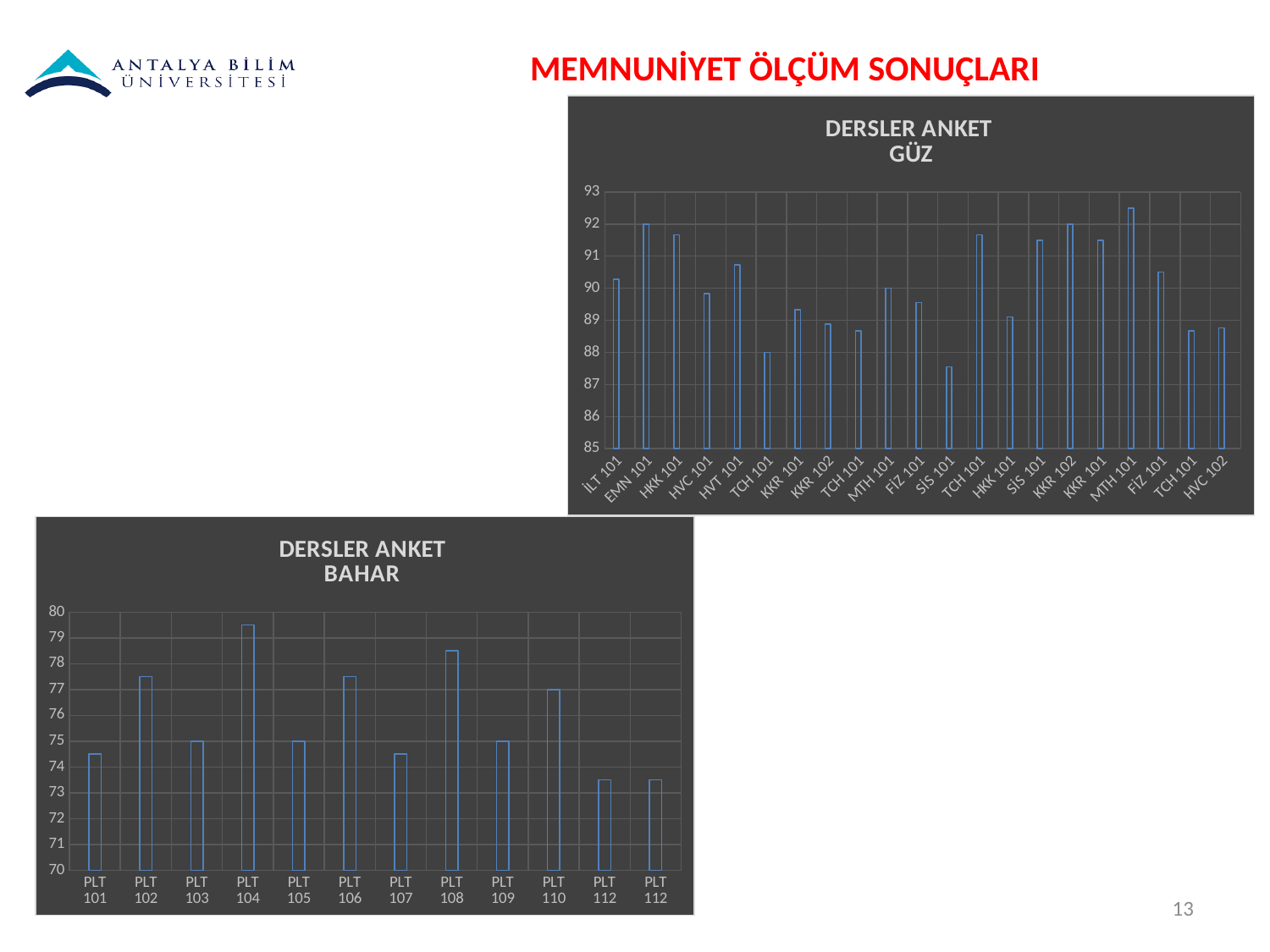
In the DERSLER ANKET GÜZ chart, which is larger, the value for HVT 101 or the value for HVC 101? HVT 101 In the DERSLER ANKET BAHAR chart, what is the value for PLT 110? 77 In the DERSLER ANKET GÜZ chart, what is the value for EMN 101? 92 In the DERSLER ANKET BAHAR chart, what is the value for PLT 103? 75 What kind of chart is the DERSLER ANKET BAHAR chart? bar chart In the DERSLER ANKET BAHAR chart, is the value for PLT 108 greater or less than 78? greater In the DERSLER ANKET GÜZ chart, which course has the highest value? MTH 101 How many bars are shown in the DERSLER ANKET BAHAR chart? 12 In the DERSLER ANKET BAHAR chart, which course has the highest value? PLT 104 In the DERSLER ANKET GÜZ chart, which course has the lowest value? SİS 101 In the DERSLER ANKET GÜZ chart, is the value for HVT 101 greater or less than 90? greater In the DERSLER ANKET GÜZ chart, is the value for HVC 102 greater or less than 89? less